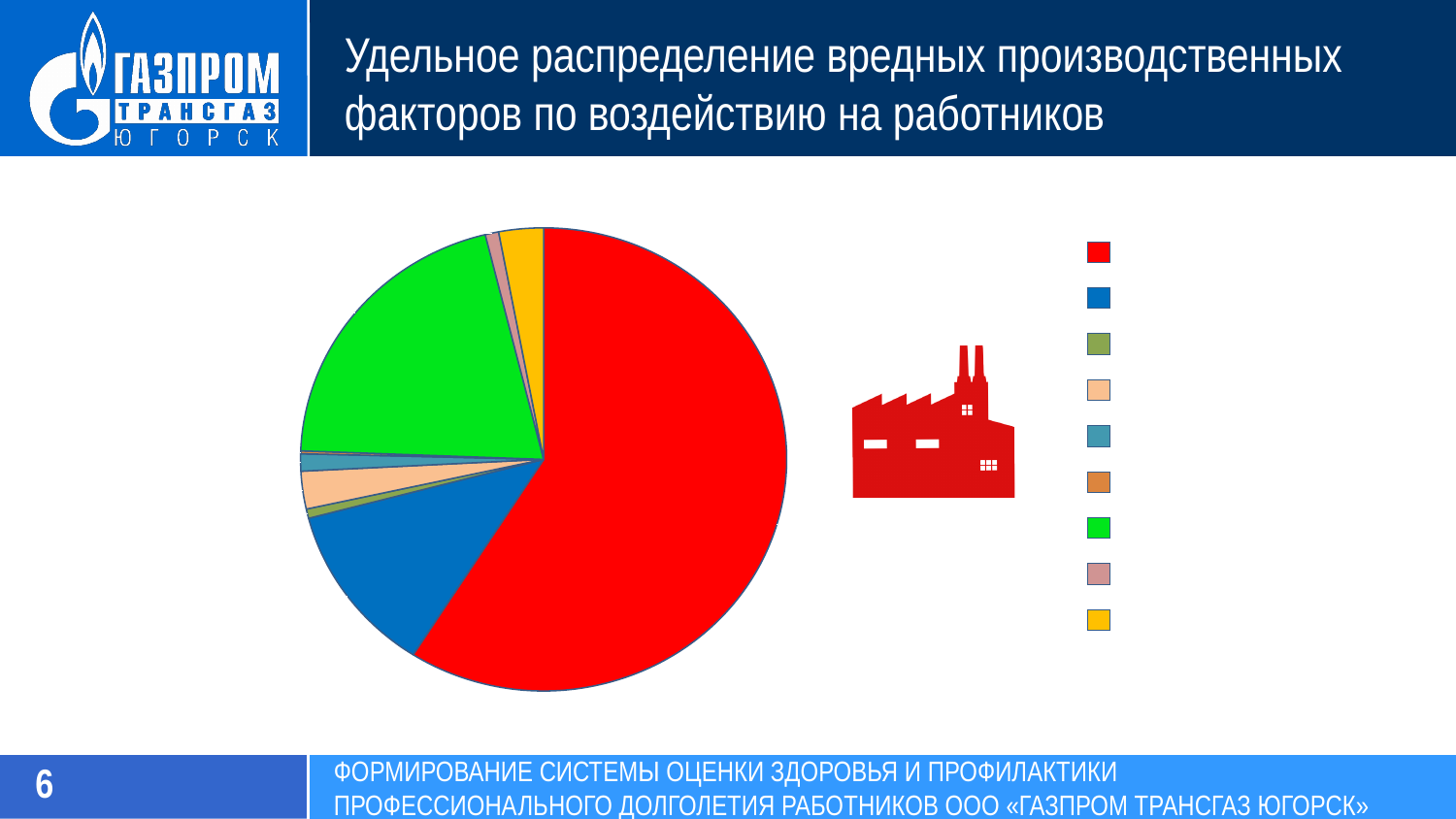
Which is larger in the pie chart, the green slice or the blue slice? the green slice Which colour slice is the largest in the pie chart? red Which colour is the second-largest slice in the pie chart? green How many entries does the legend of the pie chart show? 9 How many slices does the pie chart have? 9 Which is larger in the pie chart, the yellow slice or the pink slice? the yellow slice What is the title of the slide containing the pie chart? Удельное распределение вредных производственных факторов по воздействию на работников What kind of chart is shown on the slide? pie chart Which is larger in the pie chart, the red slice or the blue slice? the red slice